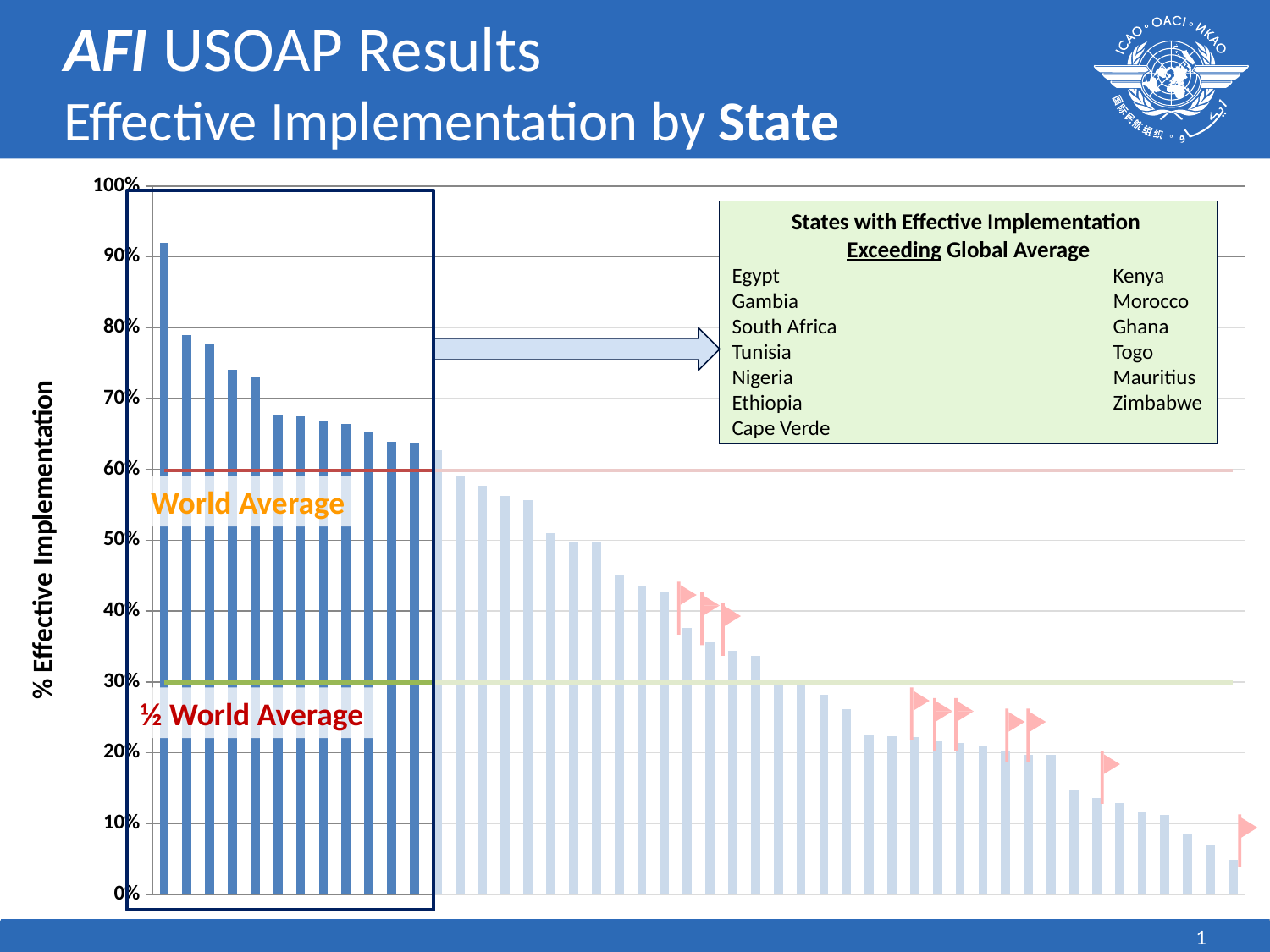
What kind of chart is shown on the slide? bar chart Is the World Average line drawn at a level greater or less than 50%? greater Is the value of the shortest bar (rightmost) greater or less than 10%? less Is the first bar to the right of the highlighted box greater or less than 70%? less Are the dark blue bars inside the highlighted box above or below the World Average line? above Do the bar values rise or fall from left to right across the chart? fall What is the label of the vertical axis? % Effective Implementation How many states are listed in the box titled 'States with Effective Implementation Exceeding Global Average'? 13